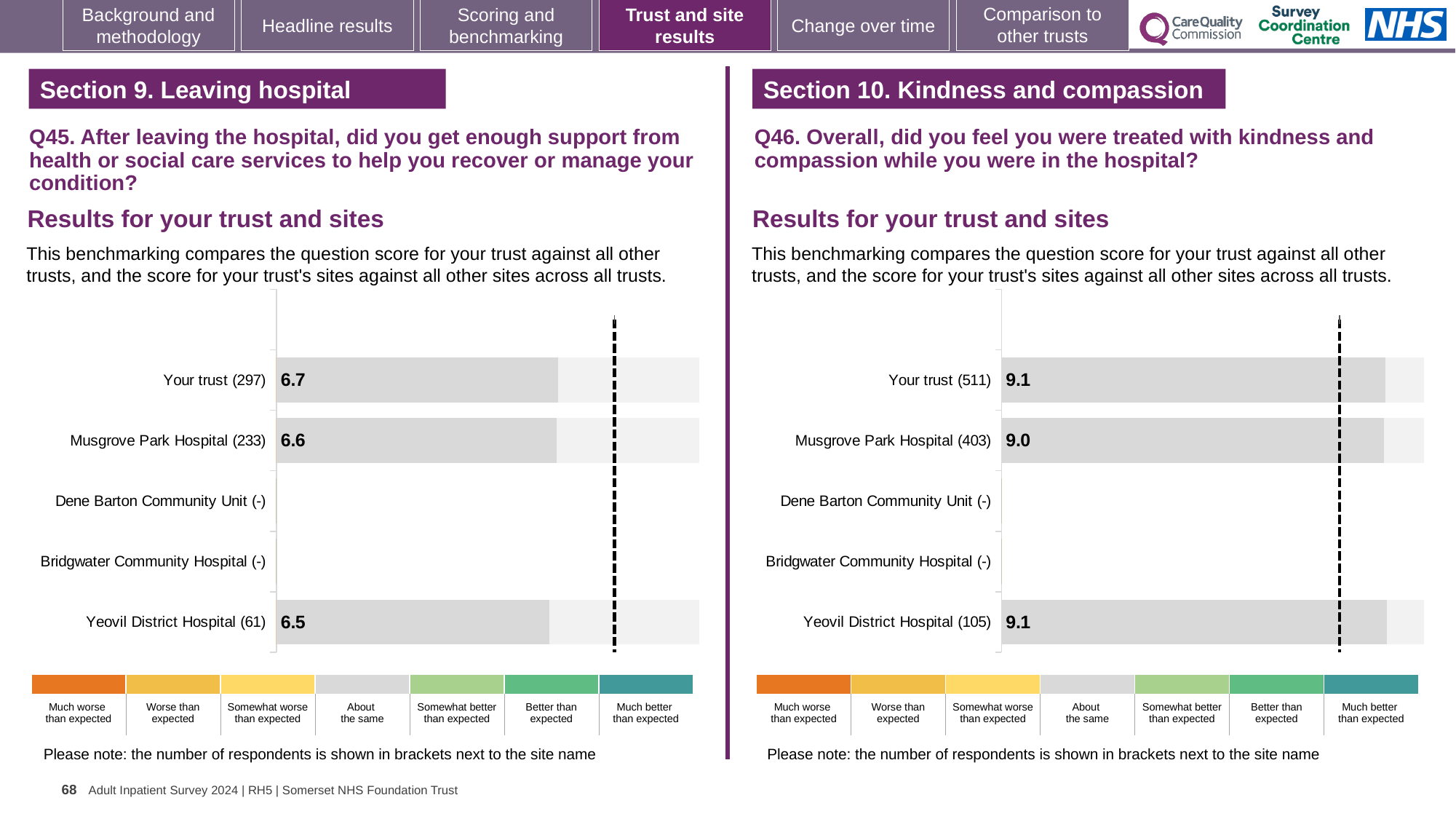
How many rows (trust and sites) are listed in the Q46 chart on the right? 5 In the Q46 chart on the right, what is the score for Musgrove Park Hospital (403)? 9.0 In the Q45 chart on the left, which has the larger score, Musgrove Park Hospital or Yeovil District Hospital? Musgrove Park Hospital In the Q45 chart on the left, what is the score for Your trust (297)? 6.7 In the Q46 chart on the right, what is the score for Yeovil District Hospital (105)? 9.1 In the Q45 chart on the left, which site or trust row has the lowest score? Yeovil District Hospital (61) What kind of chart is used for the Q45 results on the left? Bar chart In the Q46 chart on the right, how many respondents are shown in brackets for Your trust? 511 In the Q45 chart on the left, what is the score for Yeovil District Hospital (61)? 6.5 In the Q46 chart on the right, what is the difference between the scores for Your trust and Musgrove Park Hospital? 0.1 In the Q45 chart on the left, which row has the highest score? Your trust (297) In the Q45 chart on the left, what is the difference between the scores for Your trust and Yeovil District Hospital? 0.2